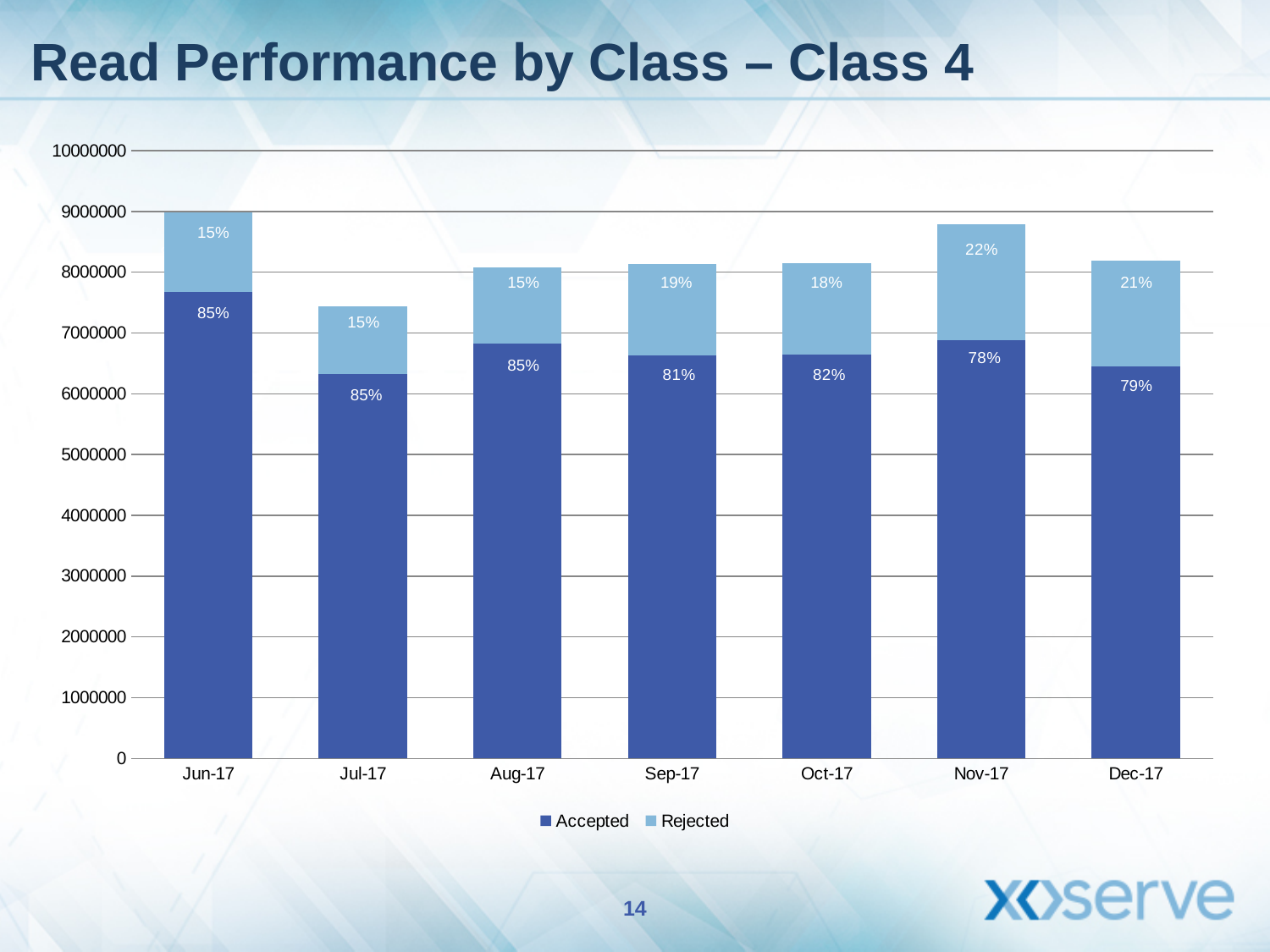
What is the Accepted percentage label for Nov-17? 78% Which month has the highest Rejected percentage label? Nov-17 Is the total height of the Jul-17 bar greater or less than 8000000? less What is the Rejected percentage label for Sep-17? 19% What are the two series named in the legend? Accepted and Rejected What is the Rejected percentage label for Dec-17? 21% How many months are shown on the x axis of the chart? 7 By how many percentage points does the Rejected label for Nov-17 exceed the Rejected label for Jun-17? 7 How many series does the legend list? 2 Which month has the lowest Accepted percentage label? Nov-17 Which month has the shortest total bar? Jul-17 What kind of chart is shown on the slide? Stacked bar chart